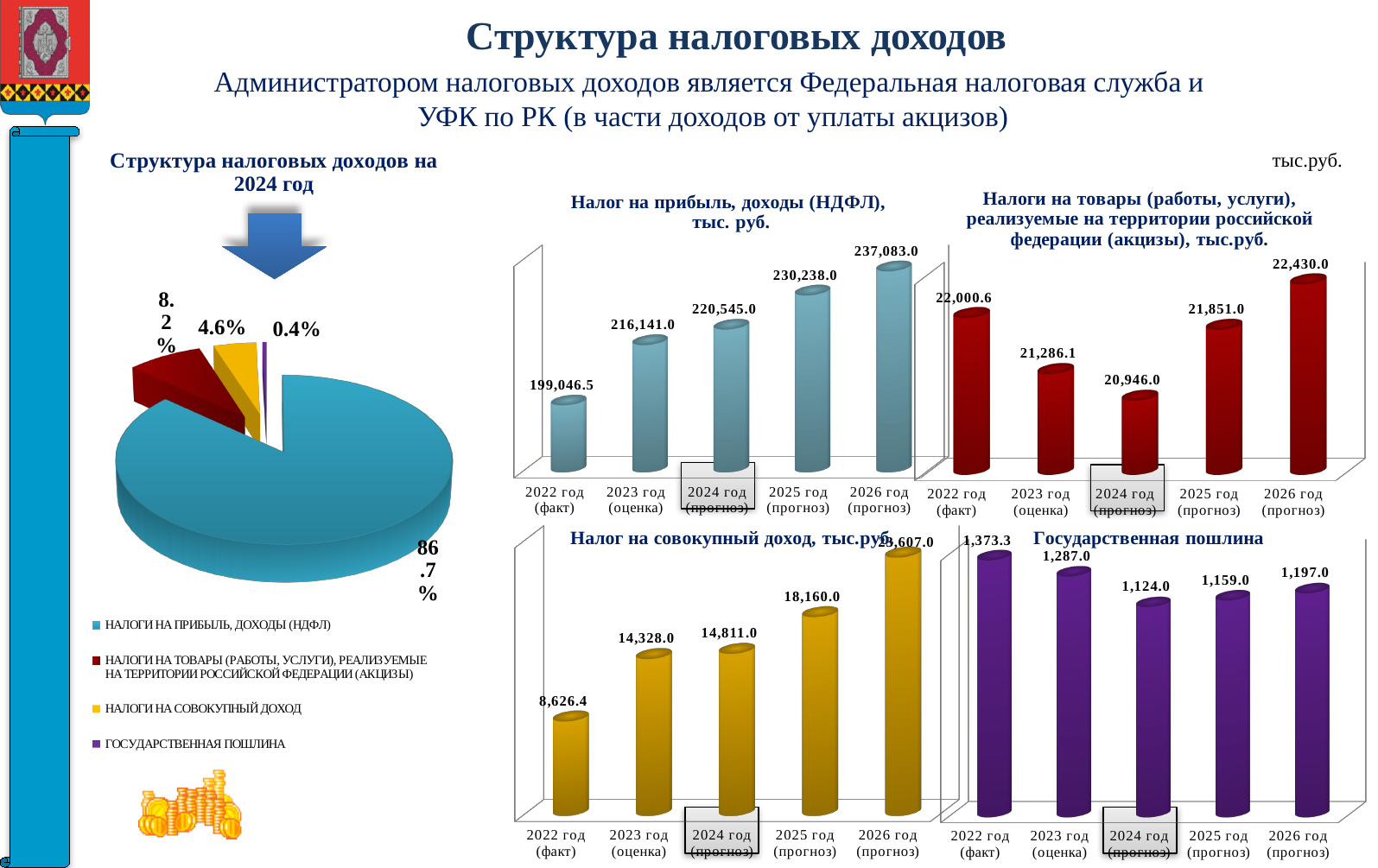
In the chart 'Налог на совокупный доход, тыс.руб.', do the values rise or fall from 2022 to 2026? rise In the pie chart 'Структура налоговых доходов на 2024 год', what share does 'НАЛОГИ НА ПРИБЫЛЬ, ДОХОДЫ (НДФЛ)' have? 86.7% In the chart 'Государственная пошлина', which is larger: the value for 2025 год (прогноз) or 2026 год (прогноз)? 2026 год (прогноз) How many categories (years) are shown in the chart 'Налог на прибыль, доходы (НДФЛ), тыс. руб.'? 5 In the chart 'Налог на прибыль, доходы (НДФЛ), тыс. руб.', what is the value for 2026 год (прогноз)? 237,083.0 In the pie chart 'Структура налоговых доходов на 2024 год', what share does 'ГОСУДАРСТВЕННАЯ ПОШЛИНА' have? 0.4% In the chart 'Налог на совокупный доход, тыс.руб.', what is the difference between the values for 2026 год (прогноз) and 2022 год (факт)? 14,980.6 In the chart 'Налоги на товары (работы, услуги), реализуемые на территории российской федерации (акцизы), тыс.руб.', which year has the lowest value? 2024 год (прогноз) In the chart 'Государственная пошлина', what is the value for 2024 год (прогноз)? 1,124.0 In the chart 'Государственная пошлина', which year has the highest value? 2022 год (факт) In the chart 'Налог на прибыль, доходы (НДФЛ), тыс. руб.', what is the value for 2022 год (факт)? 199,046.5 In the chart 'Налоги на товары (работы, услуги), реализуемые на территории российской федерации (акцизы), тыс.руб.', what is the value for 2023 год (оценка)? 21,286.1